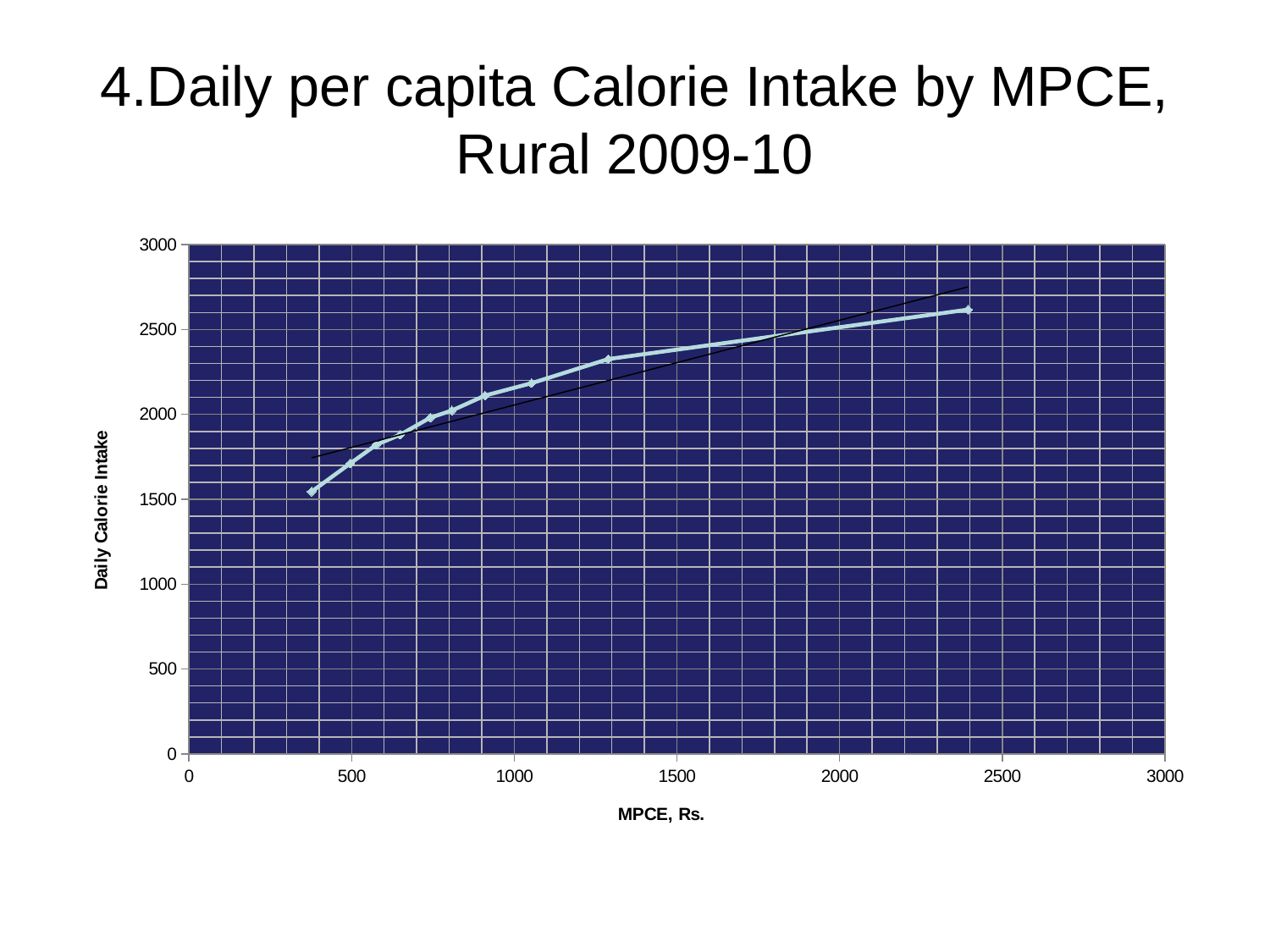
Is the daily calorie intake at an MPCE of about 1300 Rs. greater or less than 2000? greater Is the daily calorie intake at the highest MPCE point (around 2400 Rs.) greater or less than 2500? greater Is the daily calorie intake at the lowest MPCE point greater or less than 2000? less Does daily calorie intake rise or fall as MPCE increases along the x axis? rise What is the title of the chart? 4.Daily per capita Calorie Intake by MPCE, Rural 2009-10 Which has the higher daily calorie intake: the point at the lowest MPCE or the point at the highest MPCE? the point at the highest MPCE What kind of chart is shown on the slide? line chart How many data points are plotted on the line? 10 What is the label of the x axis? MPCE, Rs. What is the maximum value shown on the y axis? 3000